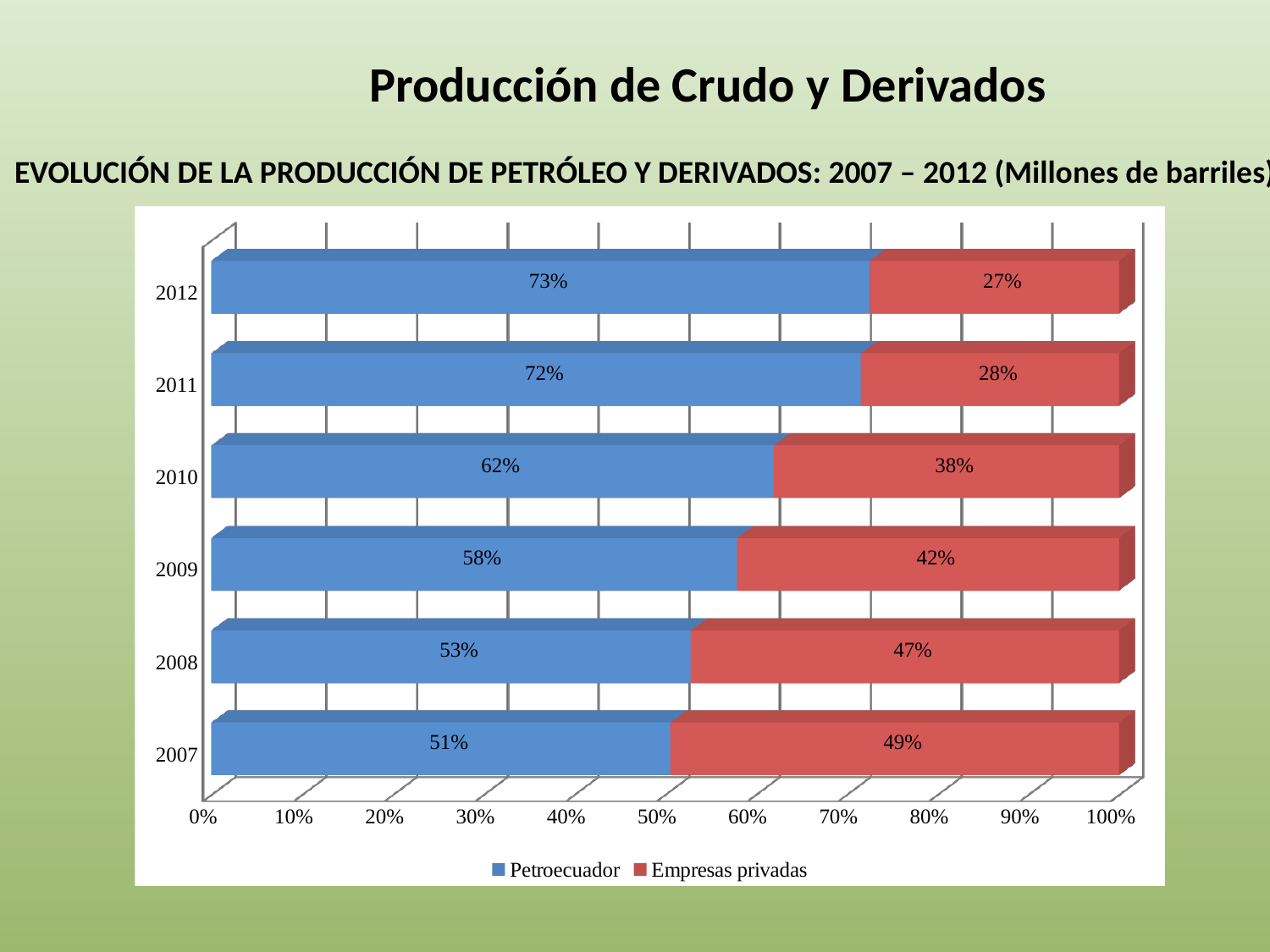
Which is larger in 2010, the Petroecuador share or the Empresas privadas share? Petroecuador What is the Empresas privadas share in 2009? 42% What is the Petroecuador share in 2007? 51% What is the difference between the Petroecuador share in 2012 and in 2007? 22% What kind of chart is shown on the slide? Stacked bar chart What is the Petroecuador share in 2012? 73% In which year is the Petroecuador share highest? 2012 Does the Petroecuador share rise or fall from 2007 to 2012? Rise How many years are shown on the chart? 6 How many series does the legend list? 2 In which year is the Empresas privadas share lowest? 2012 Which colour represents Empresas privadas in the chart? Red